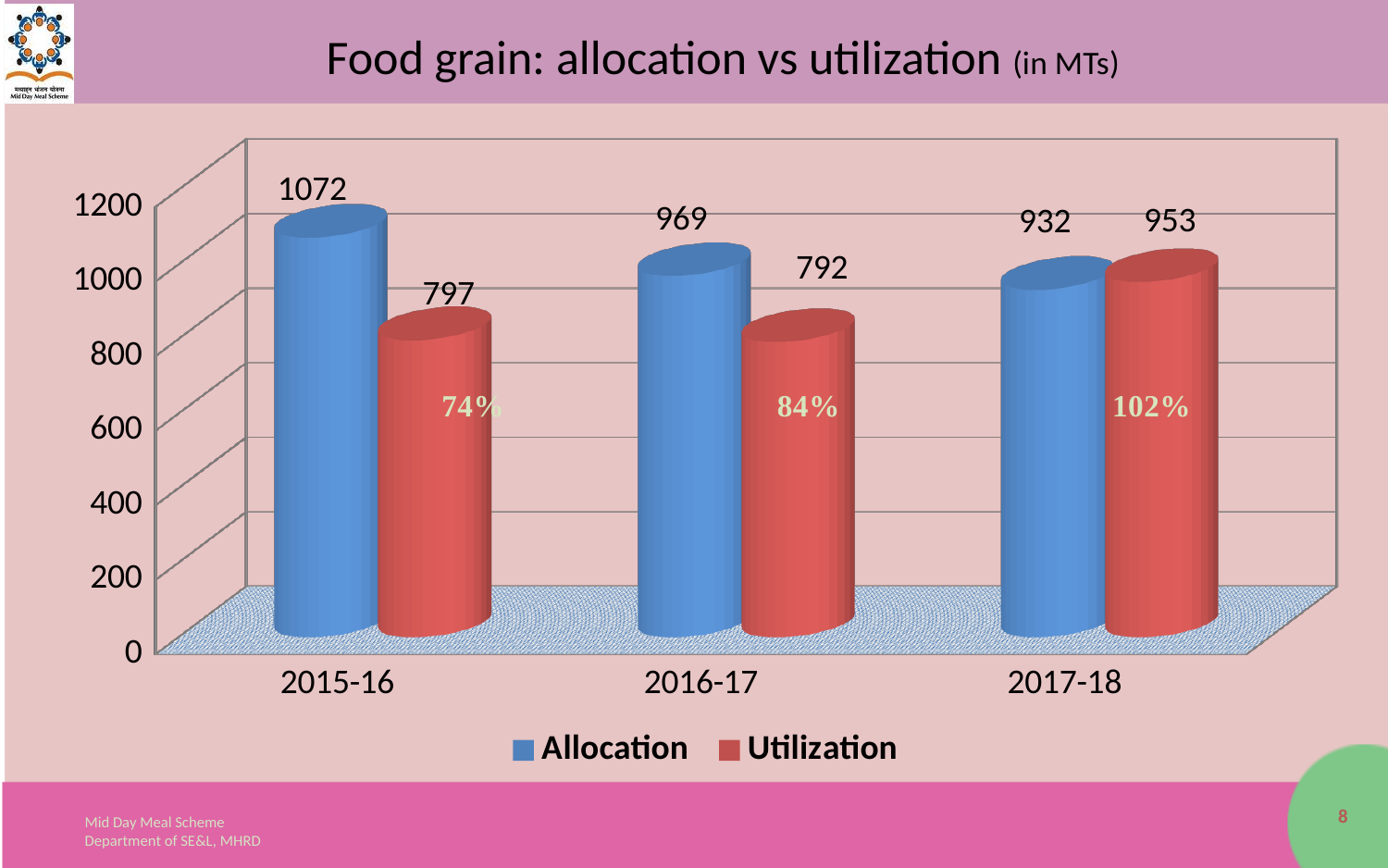
How many years are shown on the x axis? 3 Is the Allocation value for 2016-17 greater or less than 800? greater What is the Utilization value for 2016-17? 792 How many series does the legend list? 2 What percentage label is shown on the Utilization bar for 2016-17? 84% What is the Allocation value for 2015-16? 1072 In 2017-18, which is larger, Allocation or Utilization? Utilization What kind of chart is shown? bar chart What is the difference between Allocation and Utilization in 2015-16? 275 Which year has the highest Allocation? 2015-16 What is the Utilization value for 2017-18? 953 Which year has the lowest Utilization? 2016-17